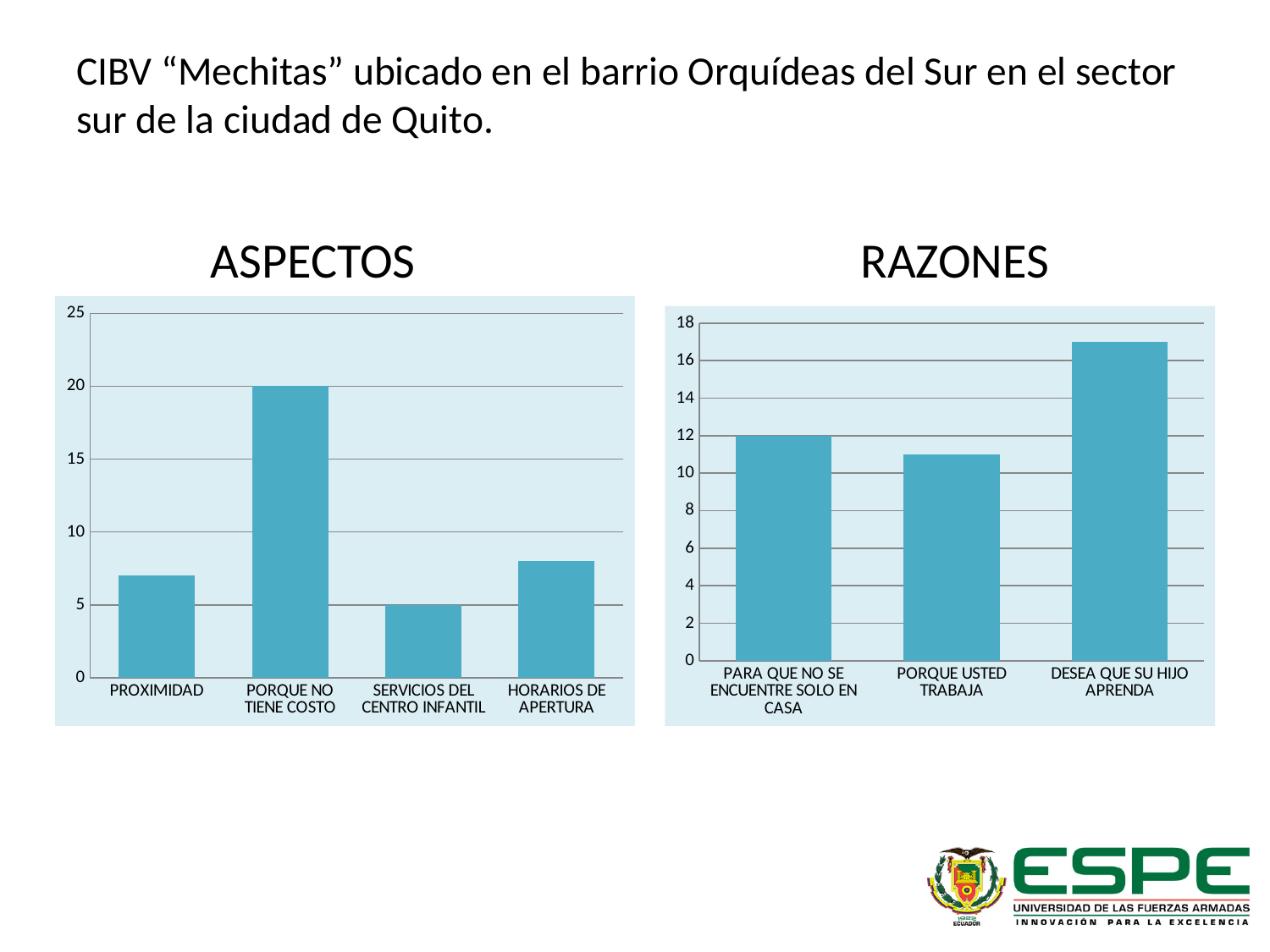
In the ASPECTOS chart, what is the value for SERVICIOS DEL CENTRO INFANTIL? 5 In the ASPECTOS chart, how many categories are shown? 4 In the RAZONES chart, is the value for DESEA QUE SU HIJO APRENDA greater or less than 16? greater In the RAZONES chart, which is larger, PARA QUE NO SE ENCUENTRE SOLO EN CASA or PORQUE USTED TRABAJA? PARA QUE NO SE ENCUENTRE SOLO EN CASA In the RAZONES chart, what is the value for PARA QUE NO SE ENCUENTRE SOLO EN CASA? 12 In the ASPECTOS chart, which category has the lowest value? SERVICIOS DEL CENTRO INFANTIL In the ASPECTOS chart, what is the difference between PORQUE NO TIENE COSTO and SERVICIOS DEL CENTRO INFANTIL? 15 In the ASPECTOS chart, which category has the highest value? PORQUE NO TIENE COSTO In the RAZONES chart, which category has the highest value? DESEA QUE SU HIJO APRENDA In the ASPECTOS chart, what is the value for PORQUE NO TIENE COSTO? 20 What kind of chart is the RAZONES chart? bar chart In the ASPECTOS chart, is the value for PROXIMIDAD greater or less than 10? less